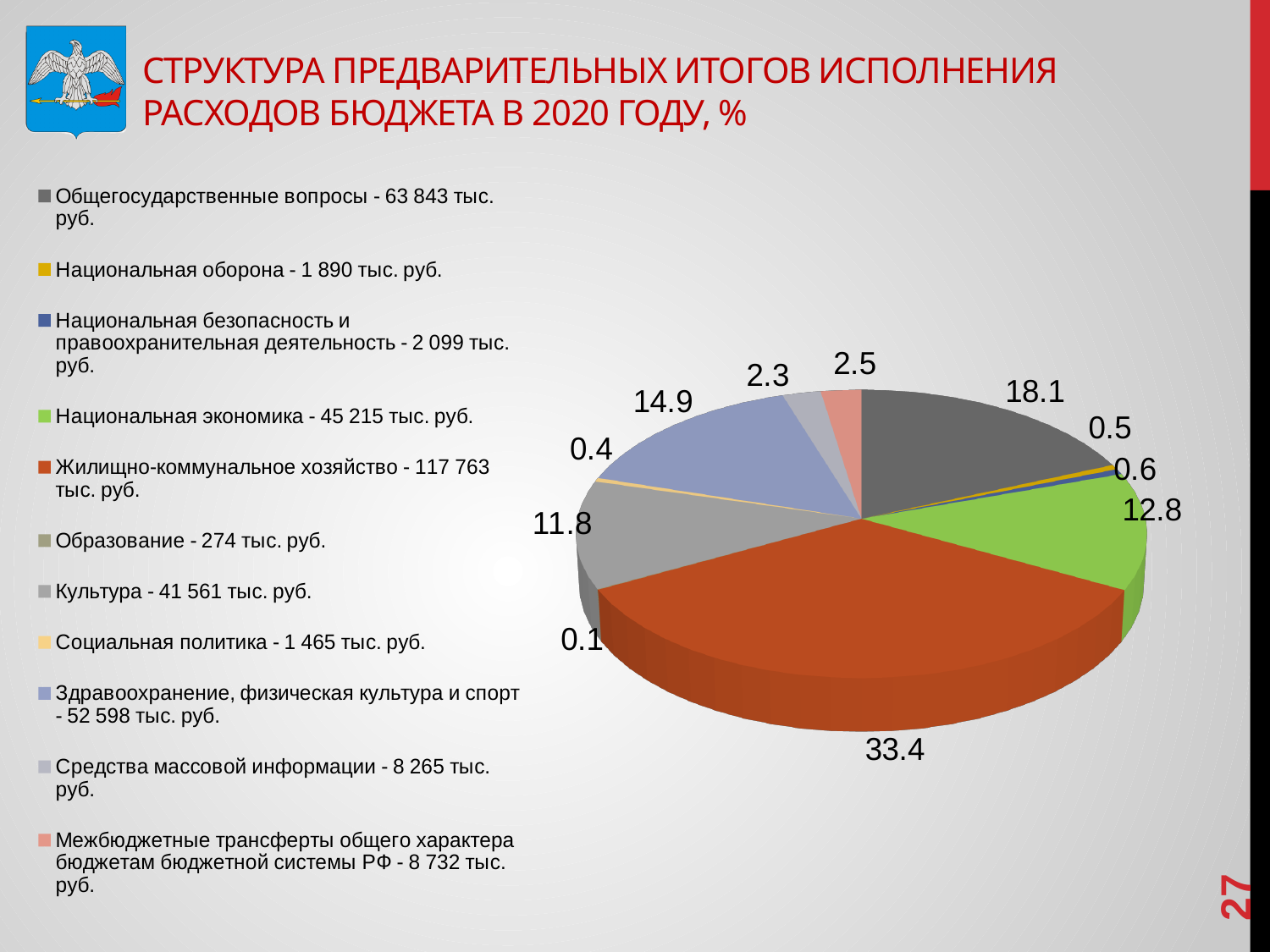
What share does Жилищно-коммунальное хозяйство have in the pie chart? 33.4 What kind of chart is shown on the slide? pie chart What share does Общегосударственные вопросы have in the pie chart? 18.1 Which category has the largest share in the pie chart? Жилищно-коммунальное хозяйство What share does Культура have in the pie chart? 11.8 What is the difference between the shares of Жилищно-коммунальное хозяйство and Общегосударственные вопросы? 15.3 According to the legend, what is the amount for Культура in thousand rubles? 41 561 тыс. руб. How many categories does the legend of the pie chart list? 11 Which category has the smallest share in the pie chart? Образование Which has the larger share: Здравоохранение, физическая культура и спорт or Национальная экономика? Здравоохранение, физическая культура и спорт What share does Здравоохранение, физическая культура и спорт have in the pie chart? 14.9 What share does Национальная экономика have in the pie chart? 12.8